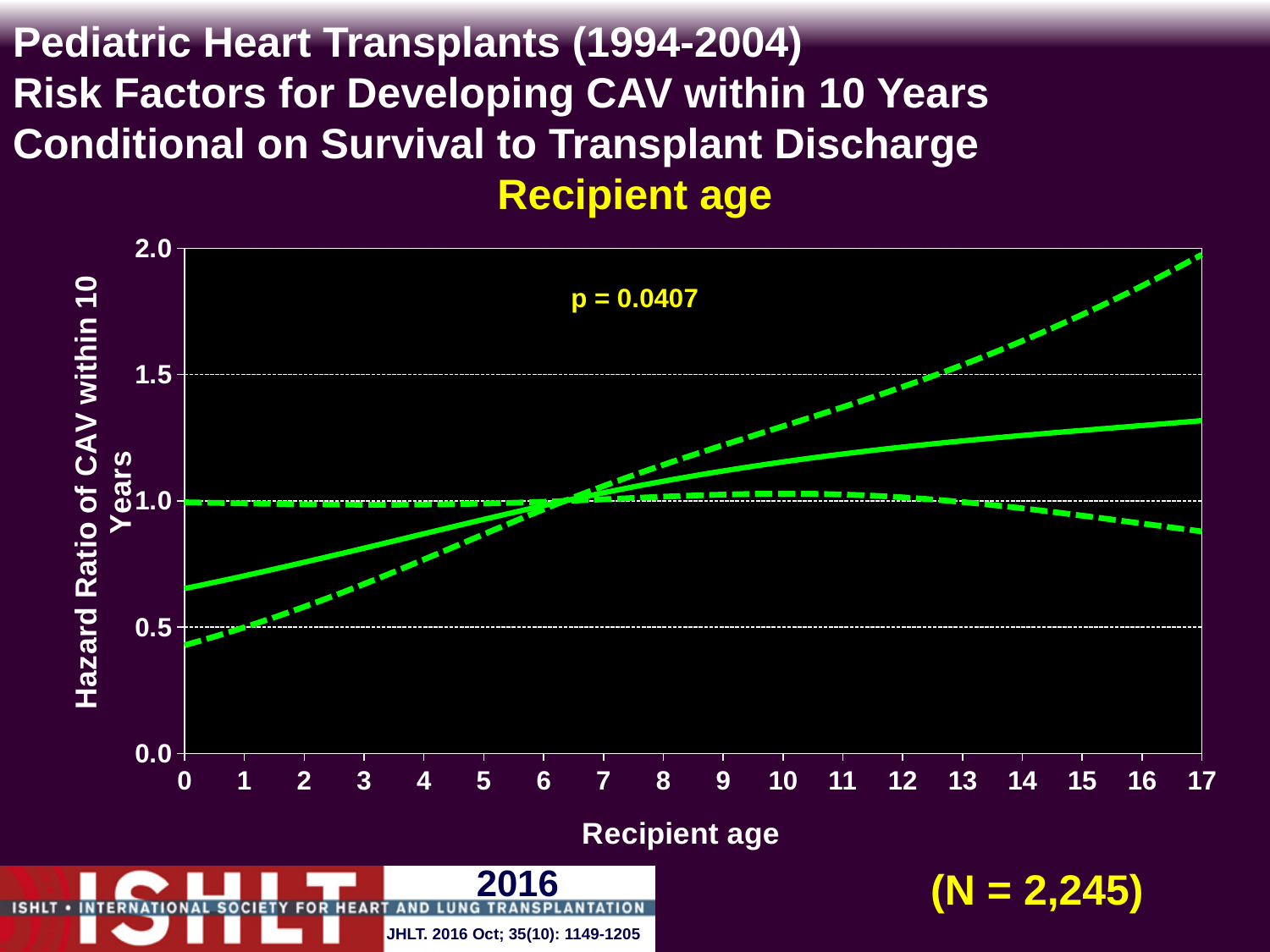
Does the solid hazard ratio line rise or fall as recipient age increases from 0 to 17? rises Is the solid hazard ratio line at recipient age 17 greater or less than 1.0? greater Is the lower dashed line at recipient age 0 greater or less than 0.5? less What p-value is printed on the chart? p = 0.0407 Is the upper dashed line at recipient age 17 greater or less than 1.5? greater How many lines are plotted on the chart? 3 What is the label of the x axis? Recipient age What kind of chart is shown on the slide? line chart Is the solid hazard ratio line higher at recipient age 17 or at recipient age 0? age 17